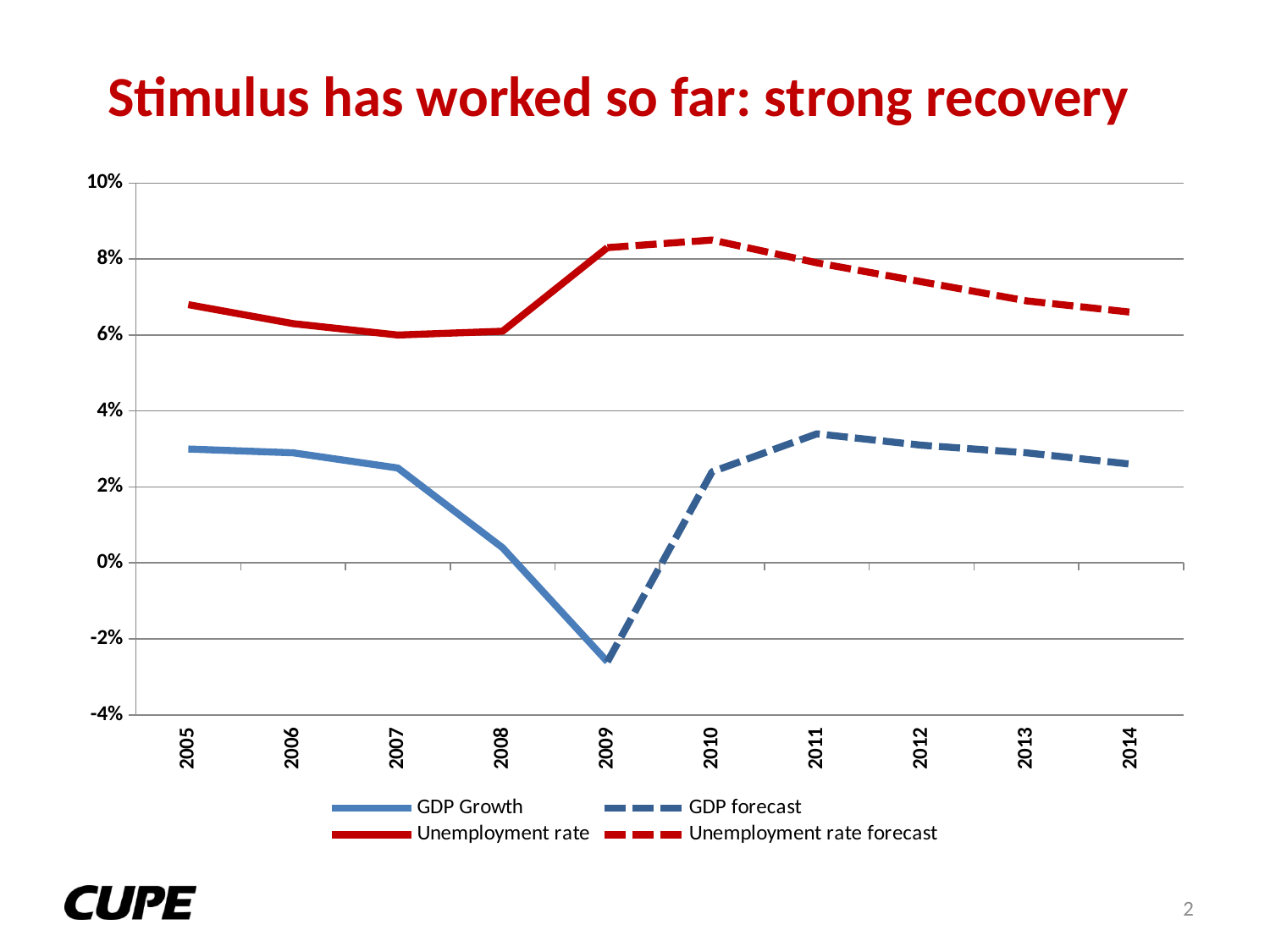
Is the GDP Growth value for 2009 greater or less than -2%? less What kind of chart is shown on the slide? line chart Does the Unemployment rate forecast rise or fall from 2010 to 2014? fall Which is larger, the Unemployment rate in 2005 or in 2007? 2005 Does GDP Growth rise or fall from 2005 to 2009? fall Is the GDP forecast value for 2011 greater or less than 4%? less Is the Unemployment rate forecast value for 2010 greater or less than 8%? greater What is the title of the slide? Stimulus has worked so far: strong recovery In which year does the Unemployment rate forecast reach its highest value? 2010 In which year is GDP Growth at its lowest? 2009 How many series does the legend list? 4 How many years are shown on the x axis? 10